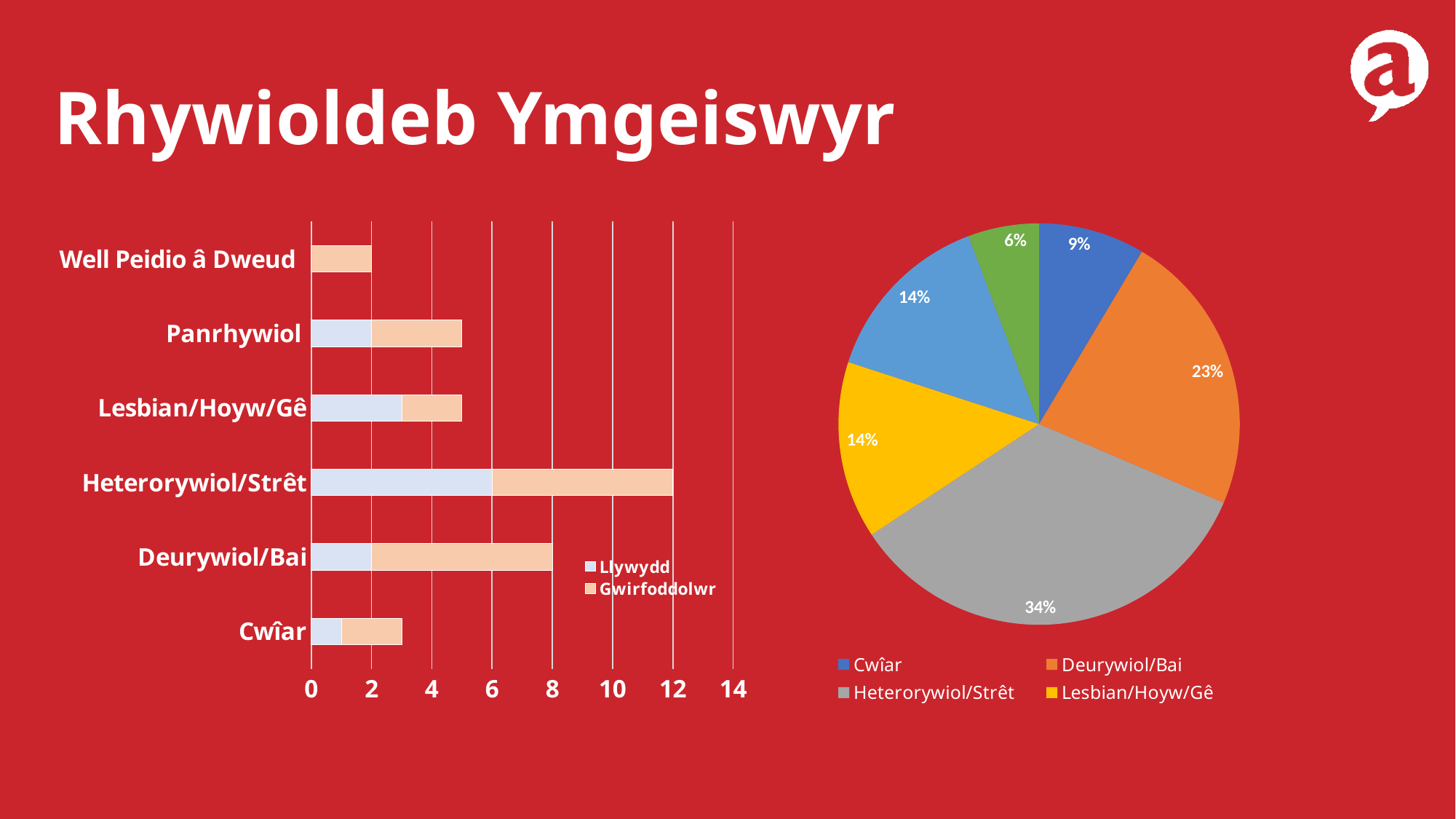
In the pie chart on the right, what share does Cwîar have? 9% In the pie chart on the right, what is the difference between the Deurywiol/Bai share and the Lesbian/Hoyw/Gê share? 9% In the bar chart on the left, what is the total length of the stacked bar for Deurywiol/Bai? 8 In the bar chart on the left, which stacked bar is longer, Deurywiol/Bai or Panrhywiol? Deurywiol/Bai What kind of chart is on the left of the slide? bar chart In the bar chart on the left, what is the total length of the stacked bar for Heterorywiol/Strêt? 12 In the bar chart on the left, how many series does the legend list? 2 In the bar chart on the left, which category has the longest stacked bar? Heterorywiol/Strêt In the bar chart on the left, is the total bar for Cwîar greater or less than 4? less What kind of chart is on the right of the slide? pie chart In the pie chart on the right, what share does Heterorywiol/Strêt have? 34% In the bar chart on the left, how many categories are shown on the vertical axis? 6